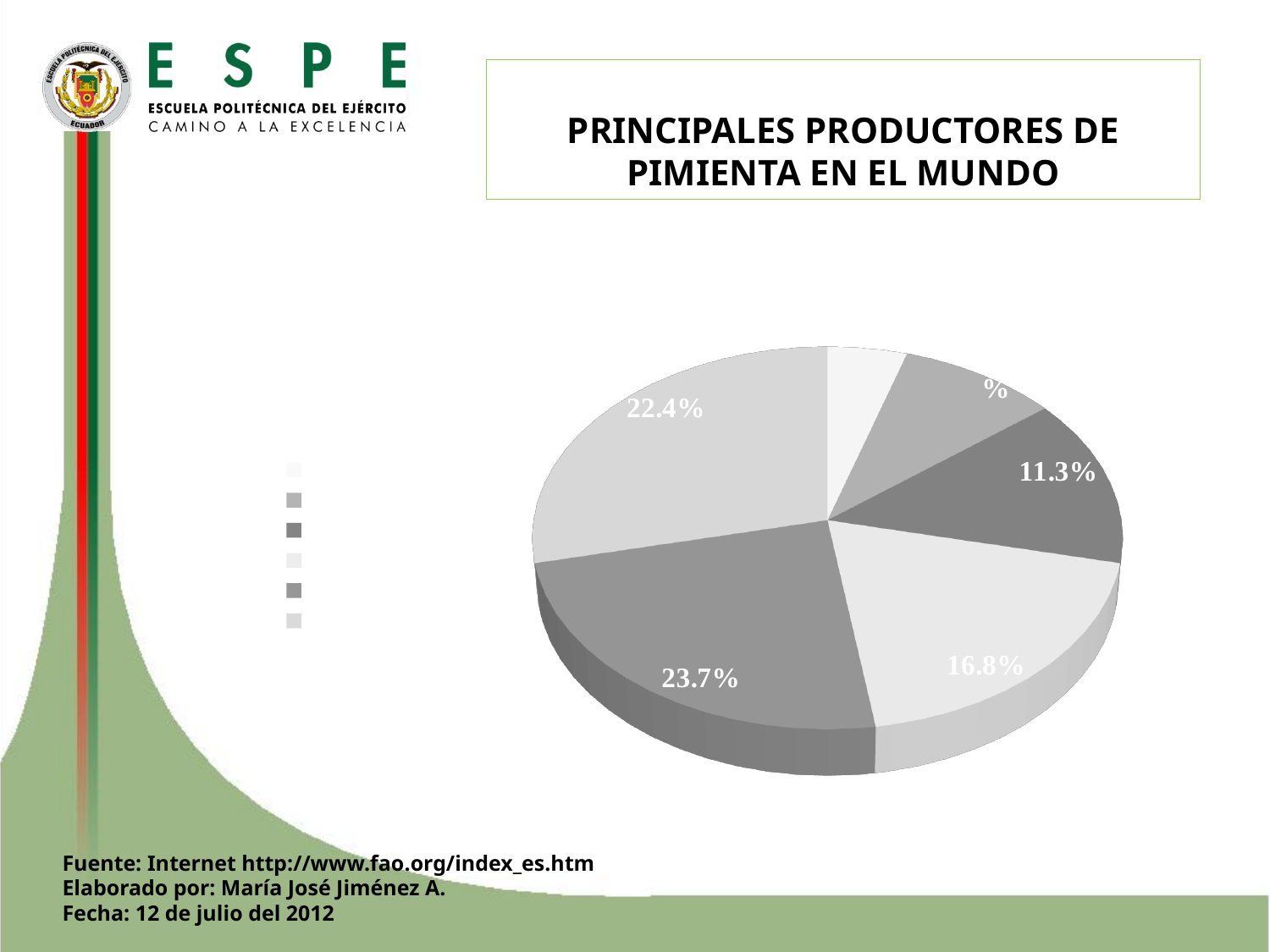
What is the largest percentage printed on the pie chart? 23.7% What kind of chart is shown on the slide? pie chart What is the combined share of the slices labelled 23.7% and 22.4%? 46.1% Which is larger, the slice labelled 22.4% or the slice labelled 16.8%? 22.4% How many entries does the legend of the pie chart list? 6 How many slices does the pie chart have? 6 What is the difference in percentage points between the 16.8% slice and the 11.3% slice? 5.5 What is the difference in percentage points between the 23.7% slice and the 22.4% slice? 1.3 What is the title of the chart on the slide? PRINCIPALES PRODUCTORES DE PIMIENTA EN EL MUNDO What is the smallest percentage printed as a full label on the pie chart? 11.3% Is the slice labelled 23.7% larger or smaller than the slice labelled 11.3%? larger